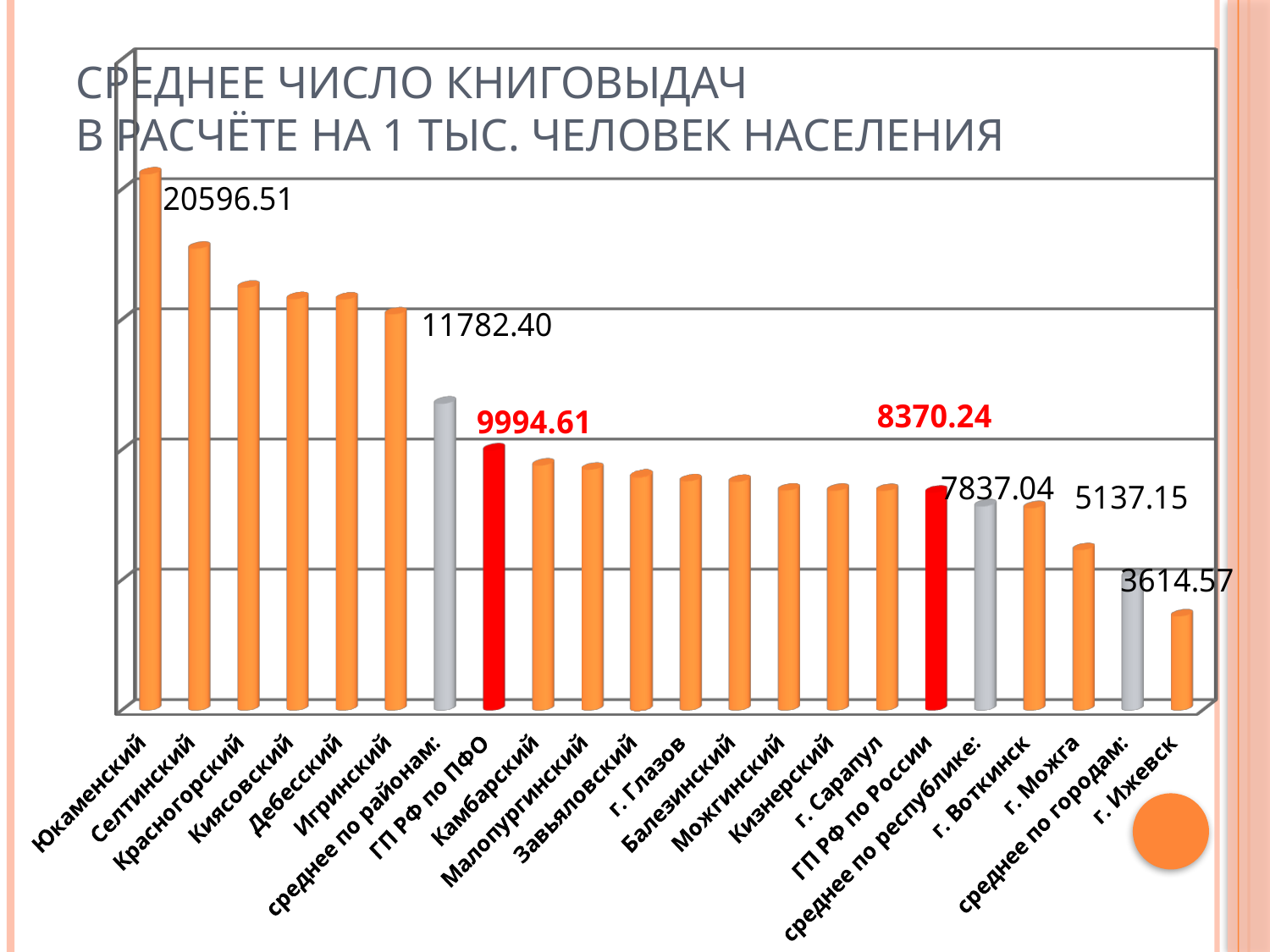
What is the value for ГП РФ по ПФО? 9994.61 Which category has the highest value? Юкаменский What is the value for г. Ижевск? 3614.57 What is the value for среднее по республике? 7837.04 What is the value for ГП РФ по России? 8370.24 What kind of chart is shown on the slide? bar chart What is the value for Юкаменский? 20596.51 Which is larger, the value for ГП РФ по ПФО or for ГП РФ по России? ГП РФ по ПФО How many categories are shown on the x axis? 22 What is the value for среднее по районам? 11782.40 Which category has the lowest value? г. Ижевск What is the difference between the values for ГП РФ по ПФО and ГП РФ по России? 1624.37